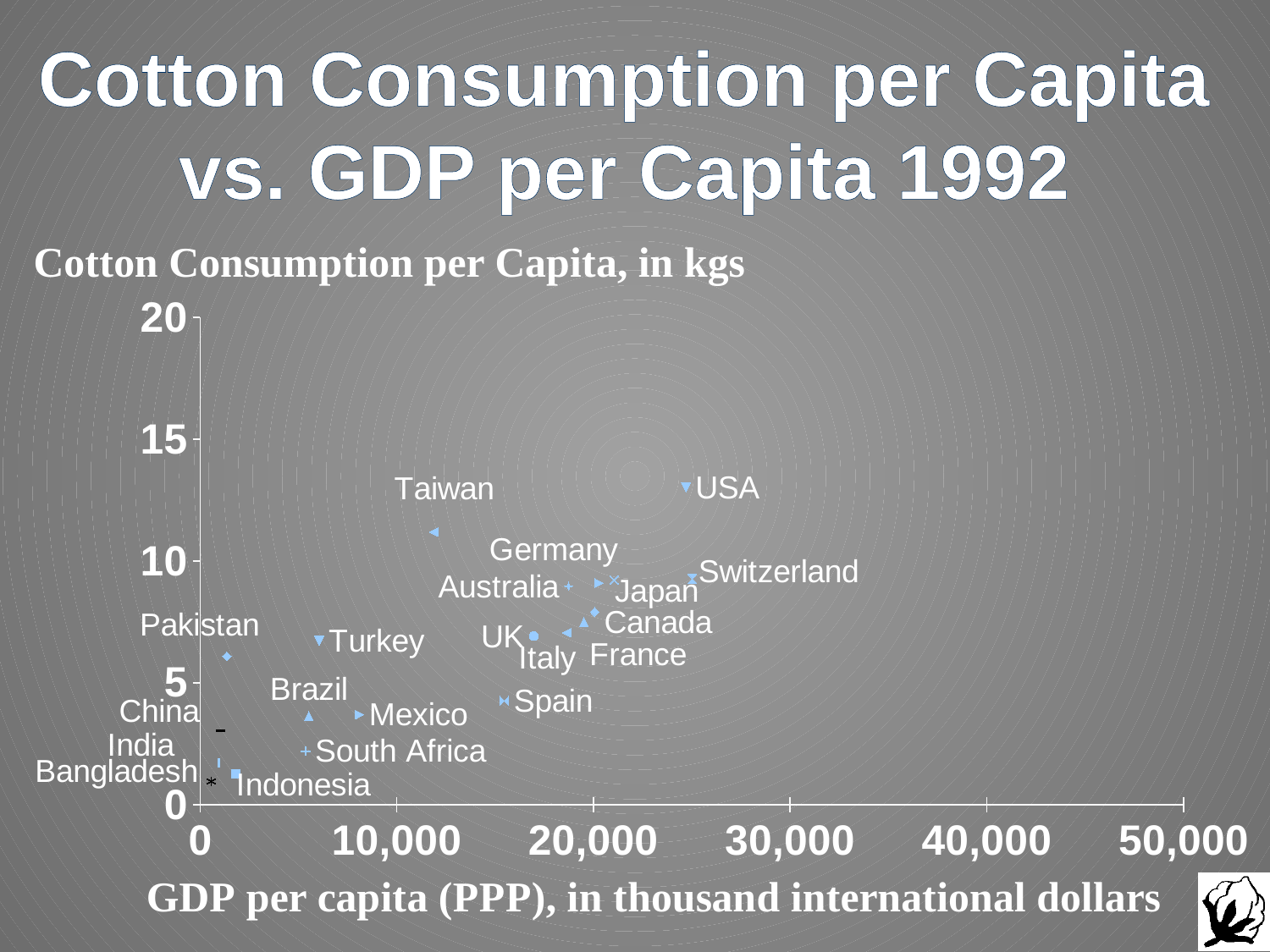
How many countries are labelled on the chart? 20 Which has higher cotton consumption per capita, Pakistan or Brazil? Pakistan Is the GDP per capita for Turkey greater or less than 10,000? less Is the cotton consumption per capita for Taiwan greater or less than 10 kgs? greater Is the cotton consumption per capita for Spain greater or less than 5 kgs? less Which country has the highest cotton consumption per capita? USA Which has higher cotton consumption per capita, the USA or Taiwan? USA What is the label of the horizontal axis? GDP per capita (PPP), in thousand international dollars What is the label of the vertical axis? Cotton Consumption per Capita, in kgs What kind of chart is shown on the slide? Scatter chart